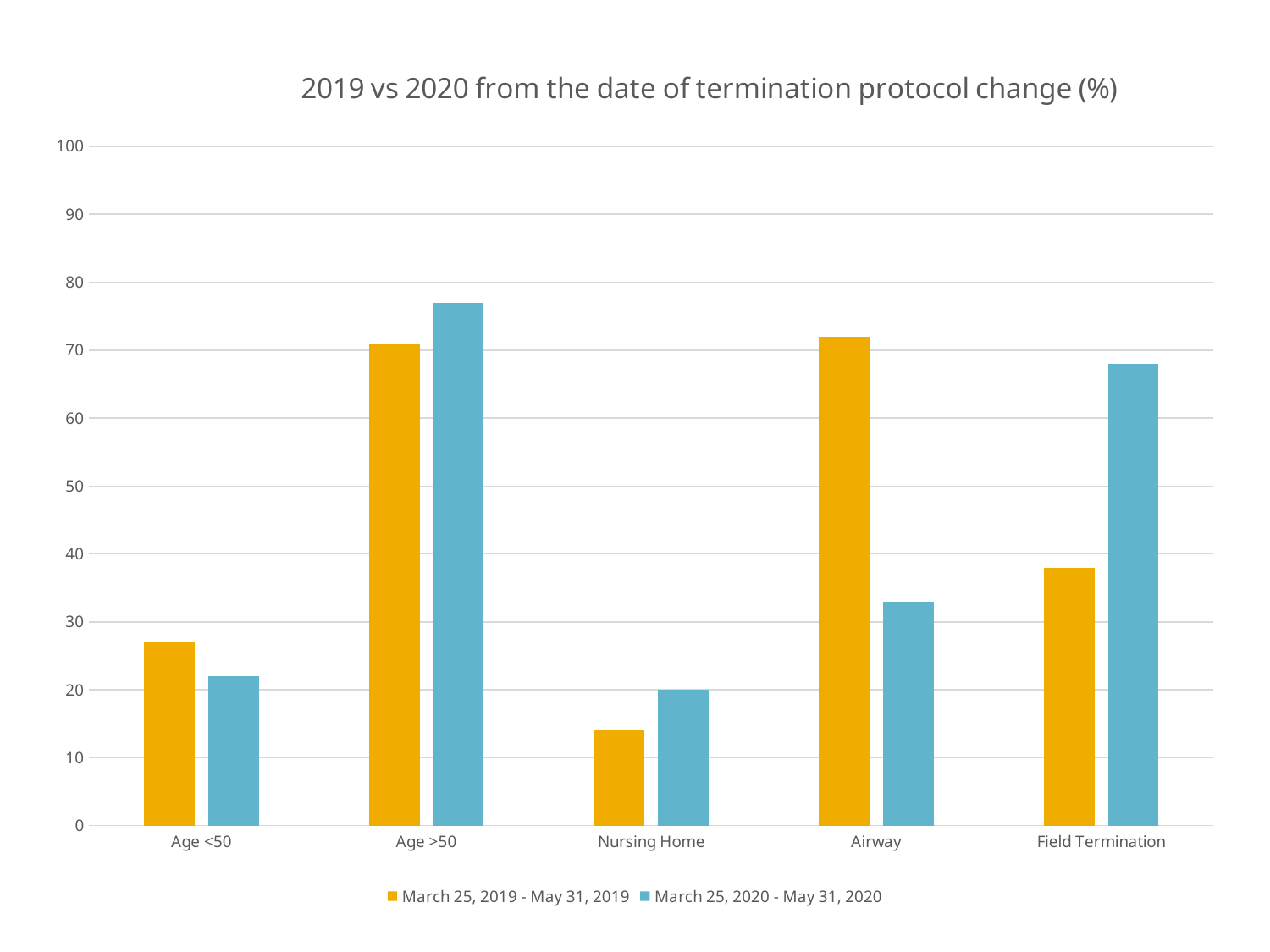
Is the value for Airway in the March 25, 2019 - May 31, 2019 series greater or less than 60? greater Is the value for Field Termination in the March 25, 2020 - May 31, 2020 series greater or less than 60? greater For Nursing Home, which series has the larger value: March 25, 2019 - May 31, 2019 or March 25, 2020 - May 31, 2020? March 25, 2020 - May 31, 2020 How many categories are shown on the x axis? 5 Which category has the lowest value for the March 25, 2019 - May 31, 2019 series? Nursing Home For Field Termination, which series has the larger value: March 25, 2019 - May 31, 2019 or March 25, 2020 - May 31, 2020? March 25, 2020 - May 31, 2020 Which category has the highest value for the March 25, 2020 - May 31, 2020 series? Age >50 Is the value for Nursing Home in the March 25, 2019 - May 31, 2019 series greater or less than 20? less For Airway, which series has the larger value: March 25, 2019 - May 31, 2019 or March 25, 2020 - May 31, 2020? March 25, 2019 - May 31, 2019 What is the title of the chart? 2019 vs 2020 from the date of termination protocol change (%) How many series does the legend list? 2 What kind of chart is shown on the slide? bar chart